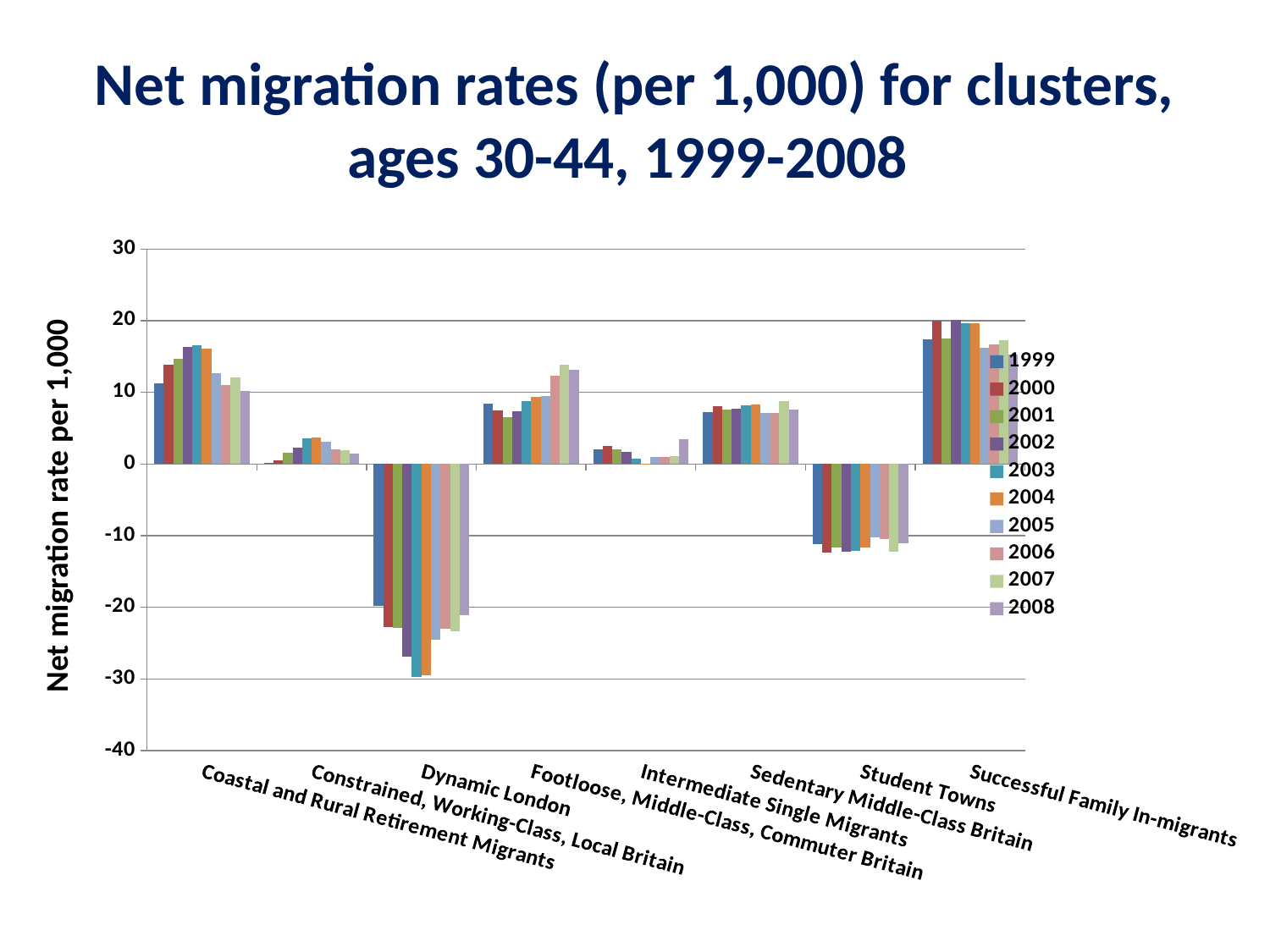
Which cluster has the highest net migration rates? Successful Family In-migrants Is the value for Student Towns in 2000 greater or less than -10? less Do the values for Footloose, Middle-Class, Commuter Britain generally rise or fall from 1999 to 2008? rise How many series (years) does the legend list? 10 Is the value for Coastal and Rural Retirement Migrants in 2003 greater or less than 10? greater What kind of chart is shown on the slide? bar chart Which is larger in 2008: the value for Sedentary Middle-Class Britain or the value for Student Towns? Sedentary Middle-Class Britain How many clusters (categories) are shown along the x axis? 8 Which cluster has the lowest (most negative) net migration rates? Dynamic London Is the value for Dynamic London in 2003 greater or less than -20? less What is the title of the y axis? Net migration rate per 1,000